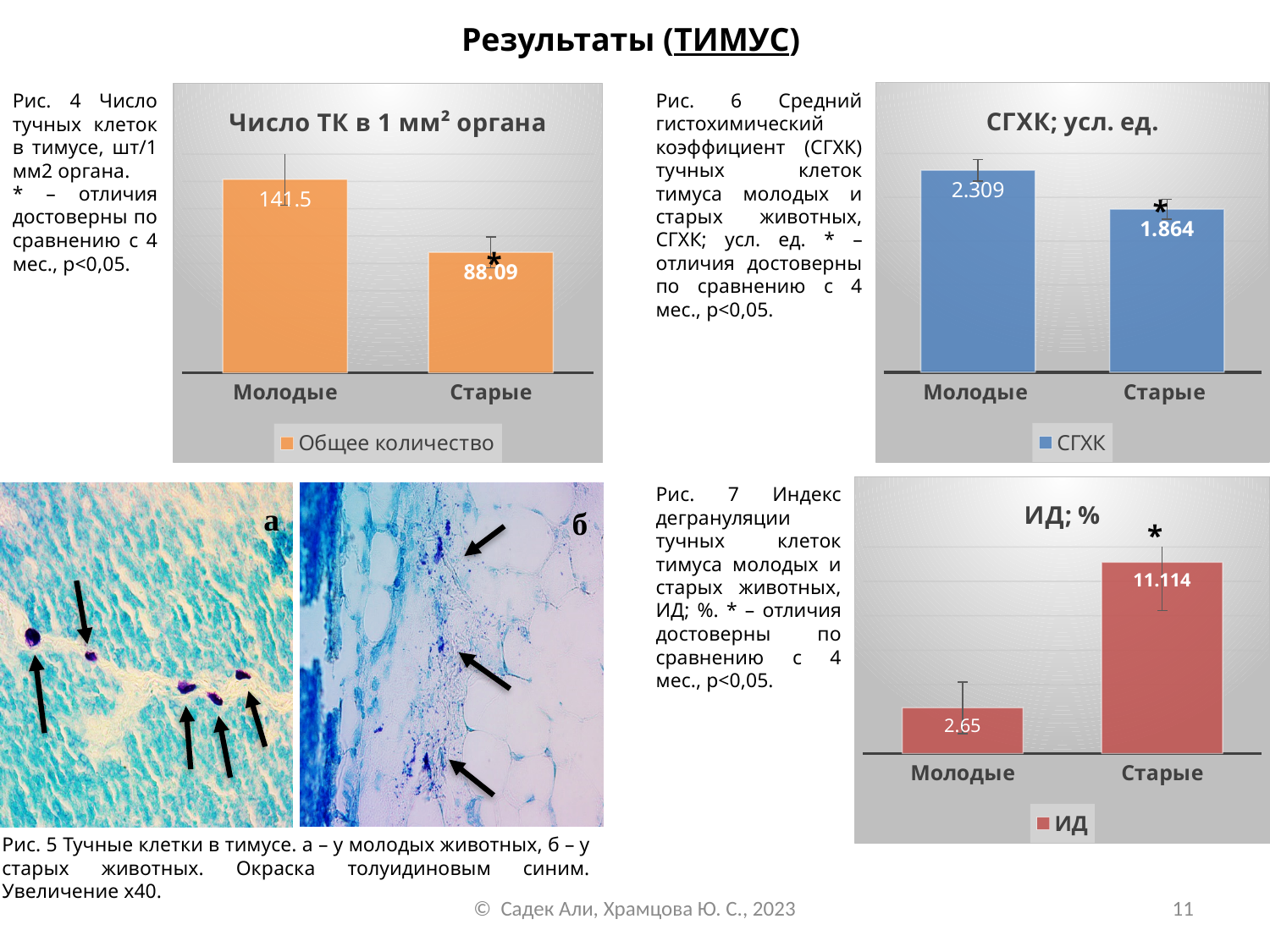
In the chart titled "СГХК; усл. ед.", which category has the lower value? Старые In the chart titled "ИД; %", what is the value for Молодые? 2.65 In the chart titled "Число ТК в 1 мм² органа", what is the difference between the values for Молодые and Старые? 53.41 In the chart titled "ИД; %", which is larger: the value for Молодые or the value for Старые? Старые In the chart titled "ИД; %", what is the value for Старые? 11.114 In the chart titled "СГХК; усл. ед.", what is the value for Старые? 1.864 In the chart titled "Число ТК в 1 мм² органа", what is the value for Старые? 88.09 In the chart titled "Число ТК в 1 мм² органа", what is the value for Молодые? 141.5 In the chart titled "Число ТК в 1 мм² органа", which category has the higher value? Молодые In the chart titled "ИД; %", what is the difference between the values for Старые and Молодые? 8.464 In the chart titled "СГХК; усл. ед.", what is the value for Молодые? 2.309 What type of chart is the chart titled "СГХК; усл. ед."? Bar chart